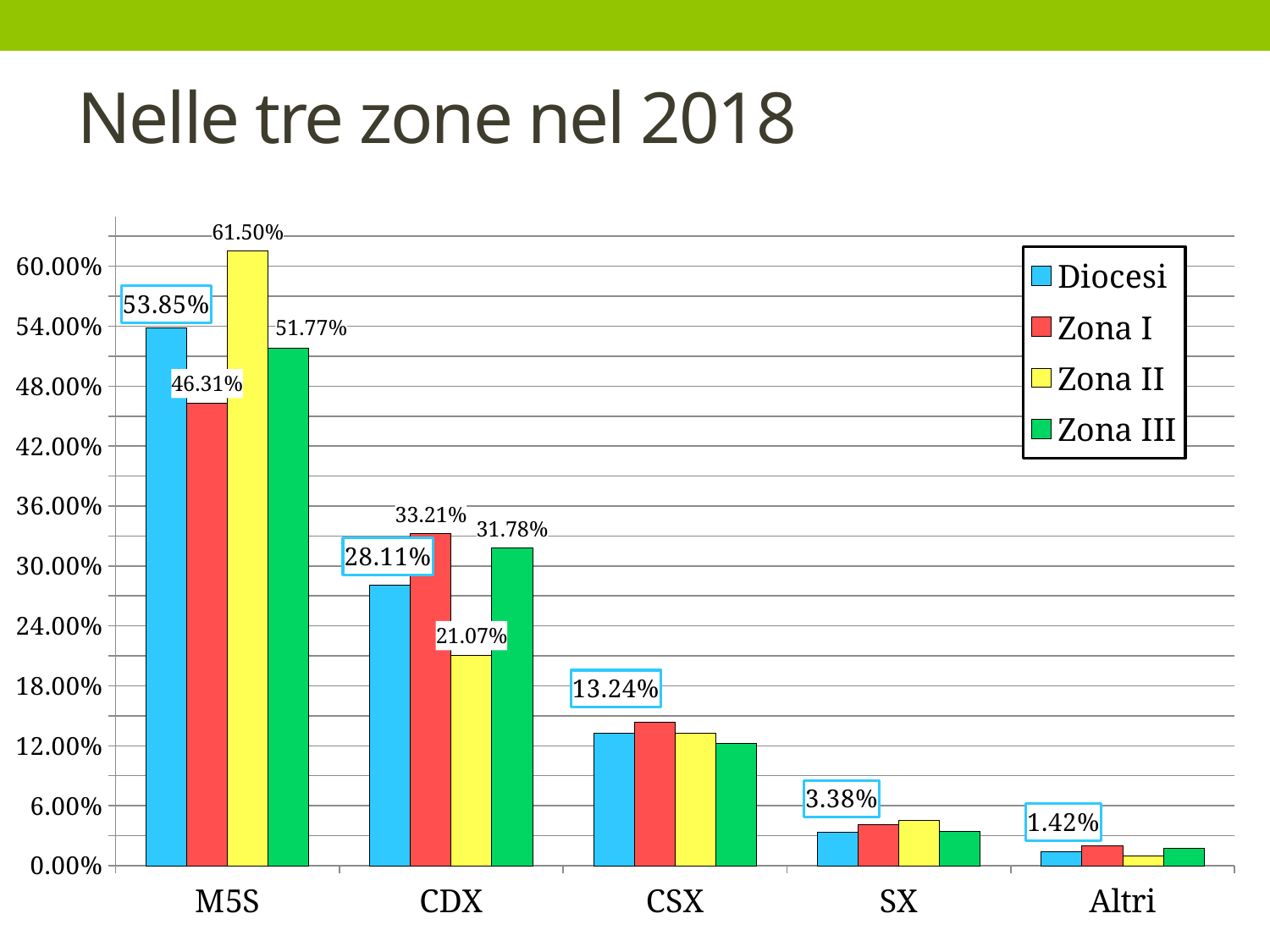
Which series has the highest value for M5S? Zona II What is the Zona III value for CDX? 31.78% Which series has the lowest value for CDX? Zona II How many categories are shown on the x axis? 5 What is the Diocesi value for SX? 3.38% What is the Diocesi value for M5S? 53.85% Is the Zona I value for CSX greater or less than 12.00%? greater What is the Zona II value for M5S? 61.50% What is the difference between the Zona II and Zona I values for M5S? 15.19% How many series does the legend list? 4 What kind of chart is shown on the slide? bar chart For CDX, which is larger: the Zona I value or the Zona III value? Zona I